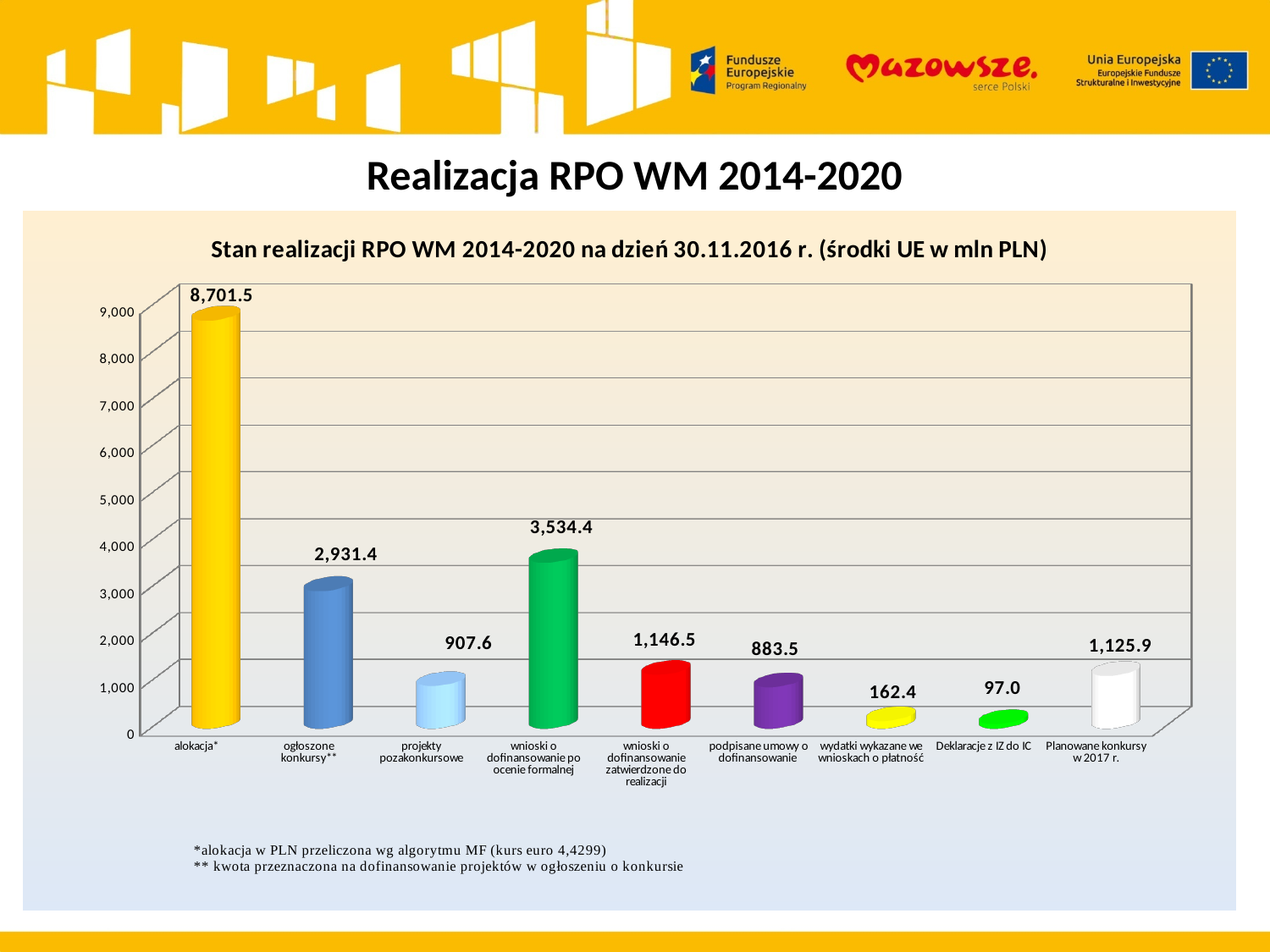
Which category has the highest value? alokacja* What is the value for ogłoszone konkursy**? 2,931.4 What is the value for wnioski o dofinansowanie po ocenie formalnej? 3,534.4 What is the value for Deklaracje z IZ do IC? 97.0 How many categories are shown in the chart? 9 What is the value for alokacja*? 8,701.5 What is the difference between the values for alokacja* and wnioski o dofinansowanie po ocenie formalnej? 5,167.1 What type of chart is shown on the slide? bar chart Which is larger: the value for wnioski o dofinansowanie zatwierdzone do realizacji or the value for podpisane umowy o dofinansowanie? wnioski o dofinansowanie zatwierdzone do realizacji What is the difference between the values for wydatki wykazane we wnioskach o płatność and Deklaracje z IZ do IC? 65.4 What is the value for Planowane konkursy w 2017 r.? 1,125.9 Which category has the lowest value? Deklaracje z IZ do IC